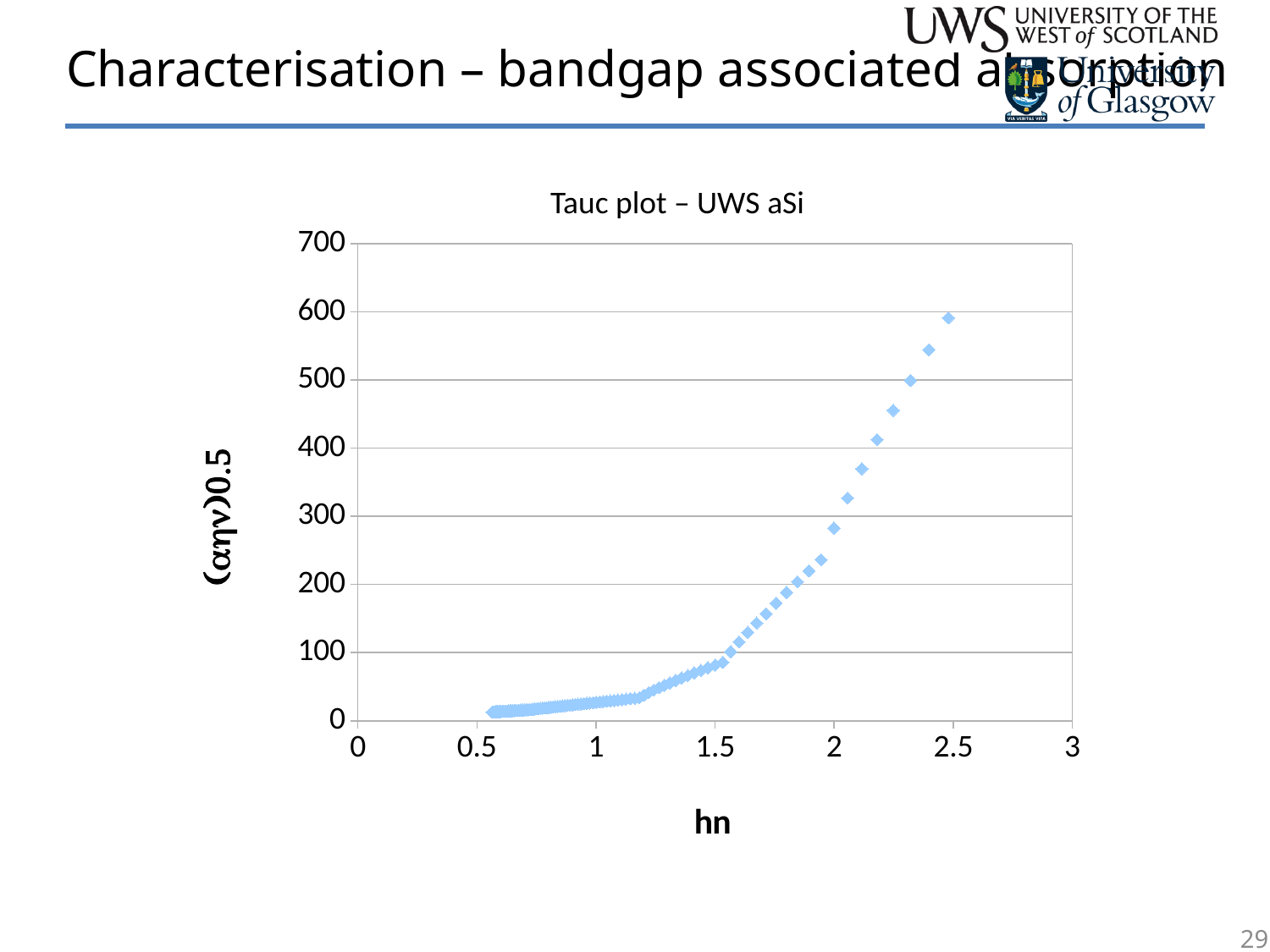
Is the plotted value at hn = 2.25 greater or less than 400? greater Is the plotted value at hn = 2 greater or less than 400? less Is the highest plotted value greater or less than 500? greater What is the label of the x axis? hn What is the title of the chart? Tauc plot – UWS aSi Which is larger, the plotted value at hn = 2 or at hn = 1.5? hn = 2 Do the plotted values rise or fall as hn increases? Rise What kind of chart is shown on the slide? Scatter chart